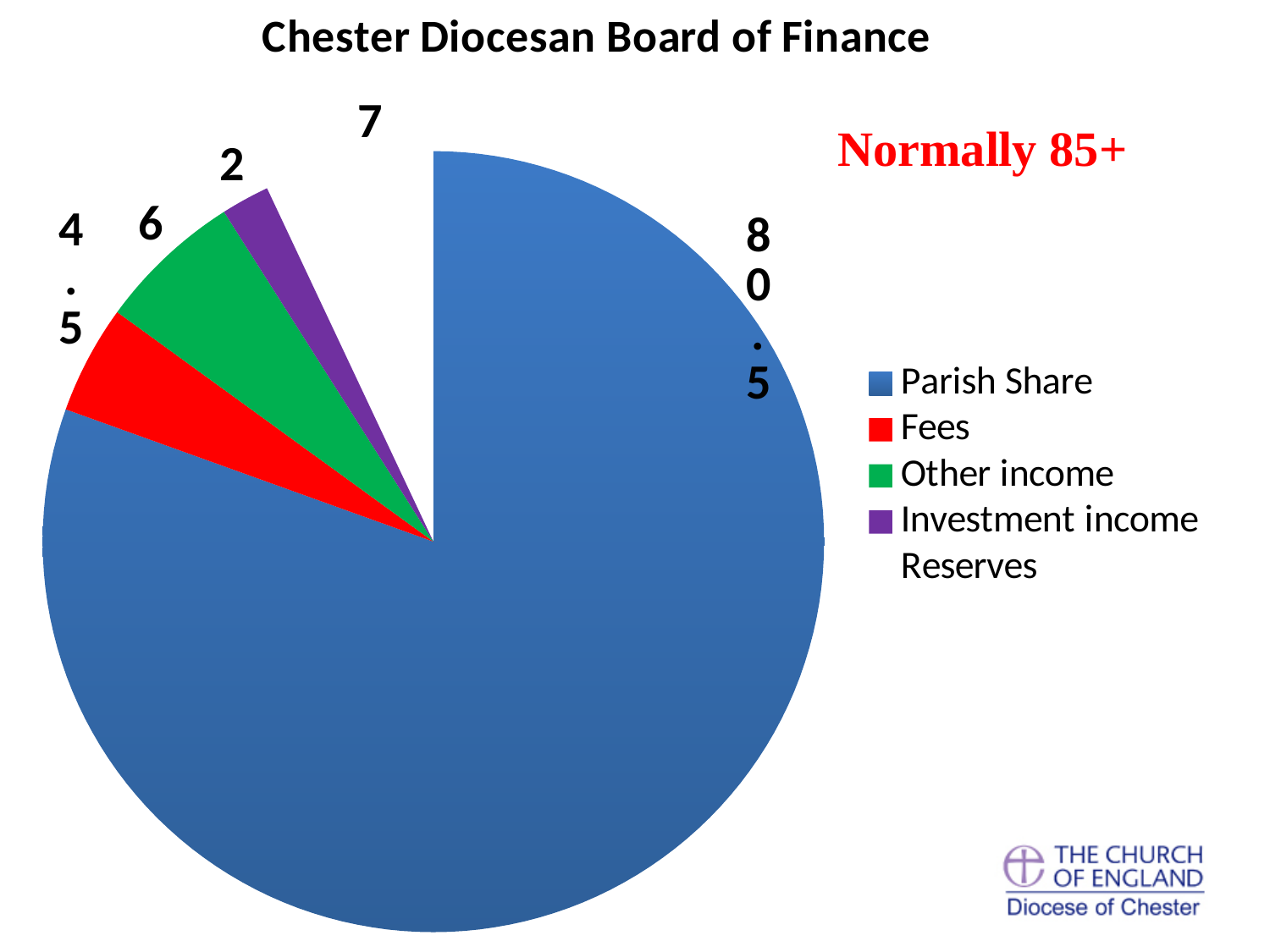
How many entries does the legend list? 5 Which is larger, the value for Fees or the value for Other income? Other income Which category has the largest slice of the pie? Parish Share What is the value shown for Fees? 4.5 What is the title of the chart? Chester Diocesan Board of Finance What is the value shown for Parish Share? 80.5 What is the difference between the values for Reserves and Other income? 1 What type of chart is shown on the slide? pie chart What is the value shown for Investment income? 2 What is the value shown for Reserves? 7 What is the value shown for Other income? 6 Which category has the smallest slice of the pie? Investment income